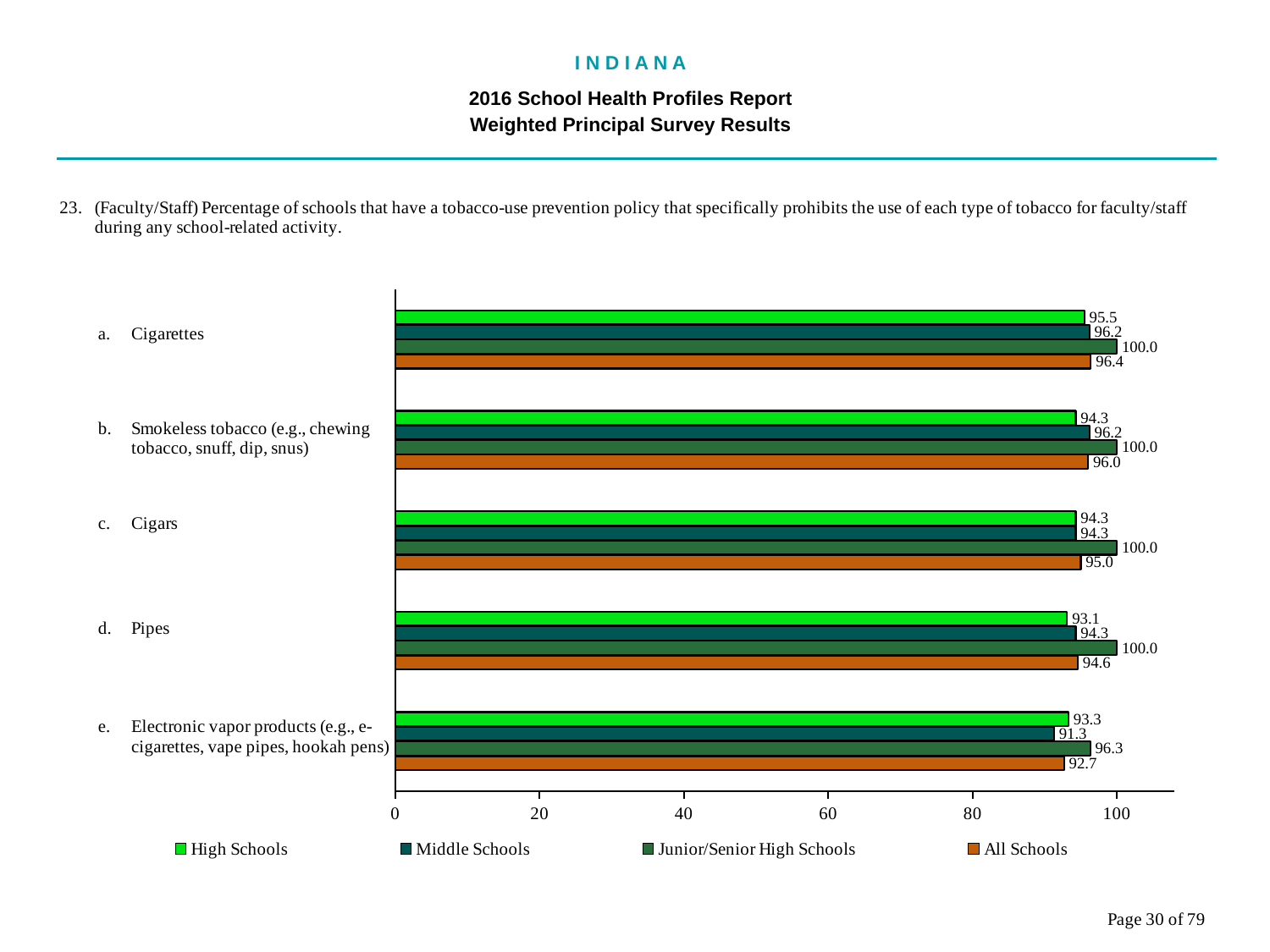
What is the value for All Schools for Electronic vapor products? 92.7 Which is larger for Pipes: the High Schools value or the All Schools value? All Schools Which category has the lowest value for Middle Schools? Electronic vapor products What is the difference between the All Schools values for Cigarettes and Electronic vapor products? 3.7 What is the value for High Schools for Cigarettes? 95.5 How many series does the legend list? 4 How many categories are shown in the chart? 5 What kind of chart is shown on the slide? Bar chart Which category has the highest value for All Schools? Cigarettes What is the value for Middle Schools for Pipes? 94.3 What is the value for Junior/Senior High Schools for Electronic vapor products? 96.3 Which series is shown in orange in the legend? All Schools